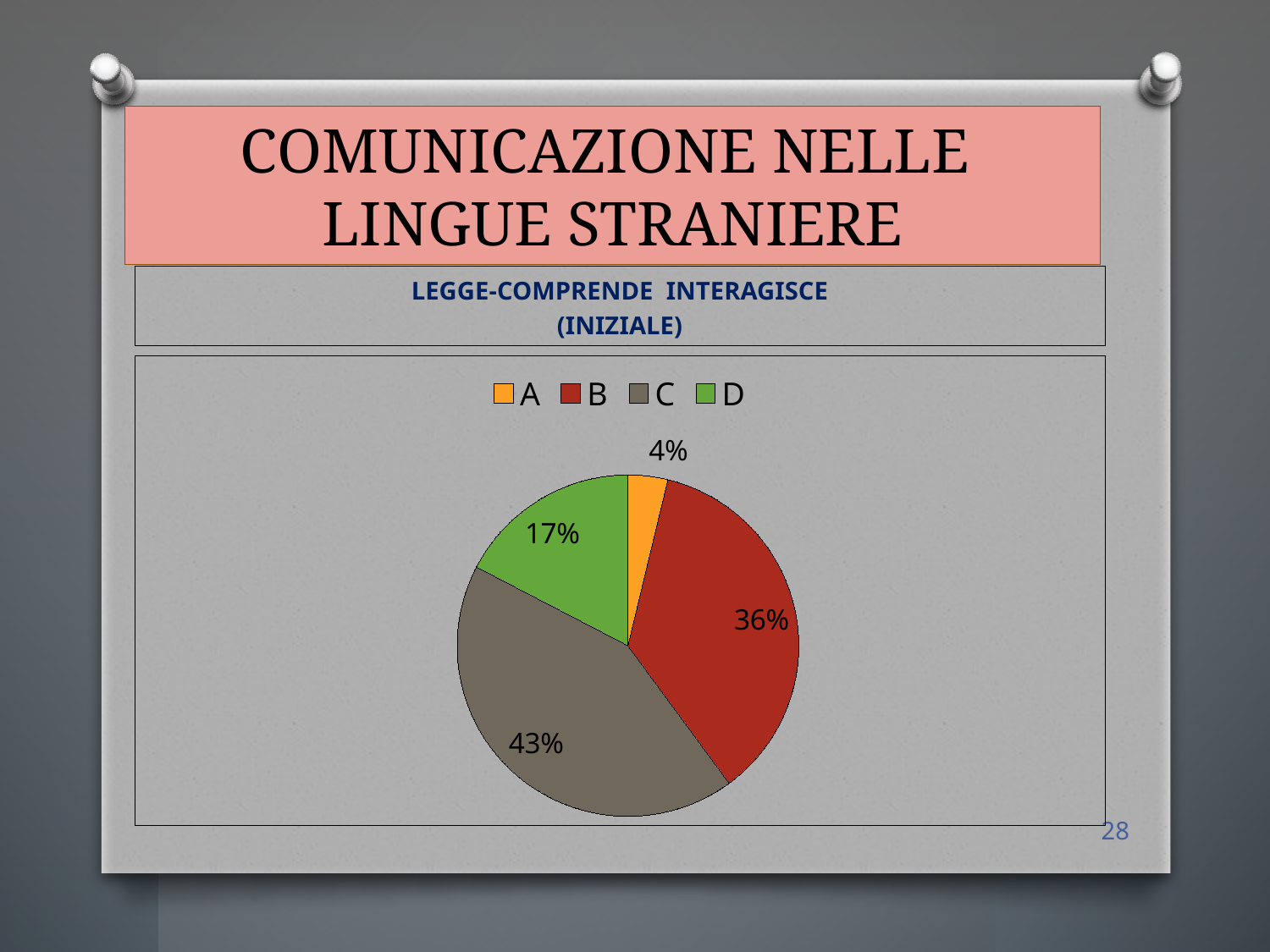
Which category has the largest slice of the pie? C What is the share for category B? 36% What kind of chart is shown on the slide? pie chart Which category has the smallest slice of the pie? A What is the difference in percentage points between category C and category B? 7 What colour is the slice for category D? green What is the title of the chart? LEGGE-COMPRENDE INTERAGISCE (INIZIALE) What is the share for category A? 4% What is the share for category C? 43% What is the share for category D? 17% Which is larger, the share for B or the share for D? B How many categories does the pie chart show? 4